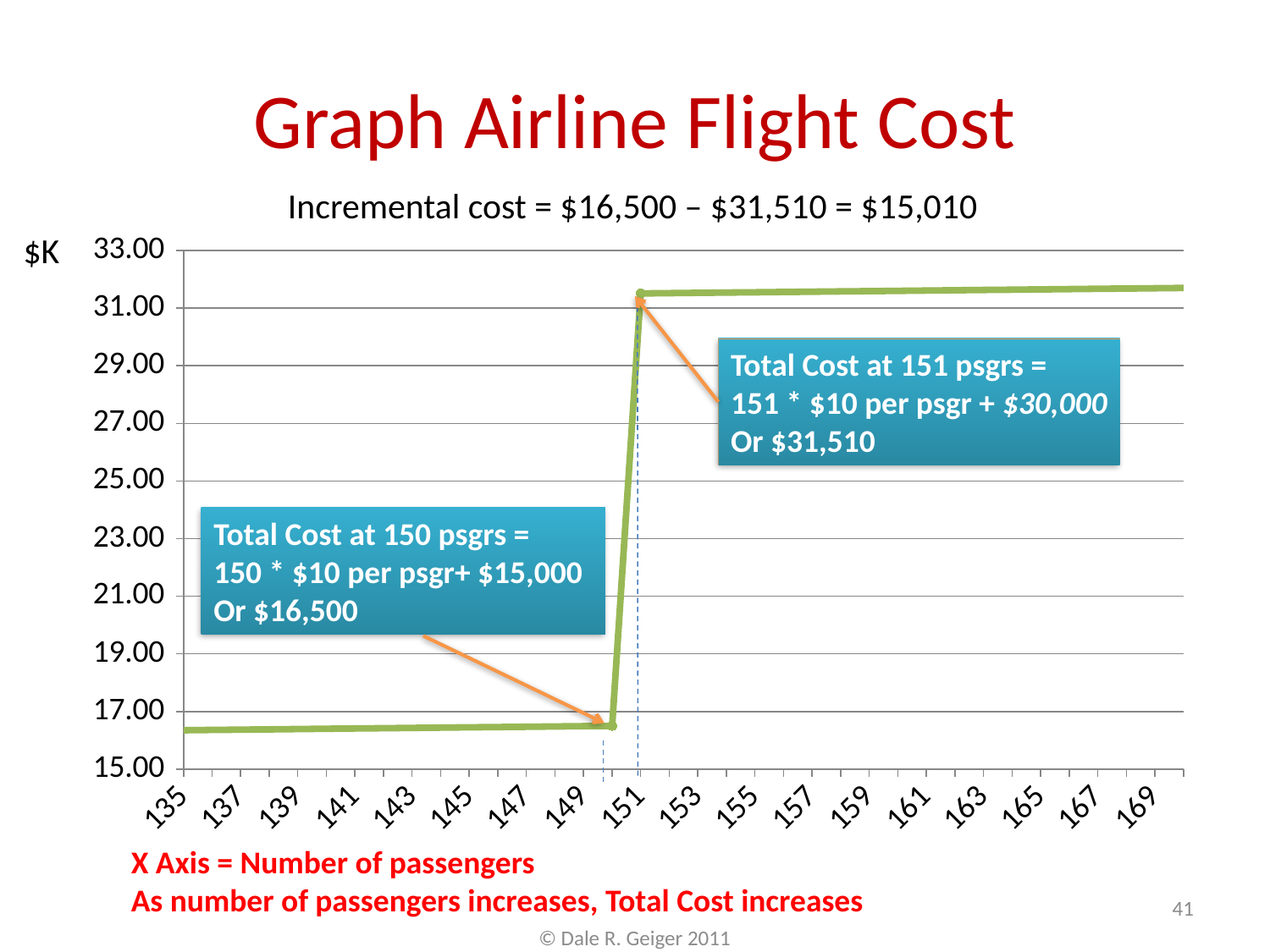
What unit is shown for the y axis? $K Is the value for 161 passengers greater or less than 31.00? greater What is the incremental cost between 150 and 151 passengers? $15,010 Is the value for 141 passengers greater or less than 17.00? less What is the total cost at 151 passengers? $31,510 What does the x axis represent? Number of passengers What is the total cost at 150 passengers? $16,500 Does total cost rise or fall as the number of passengers increases along the x axis? rises What is the fixed cost component in the total cost at 151 passengers? $30,000 Which has the larger total cost, 150 passengers or 151 passengers? 151 passengers What is the per-passenger cost used in the total cost formulas? $10 per psgr What kind of chart is shown on the slide? line chart